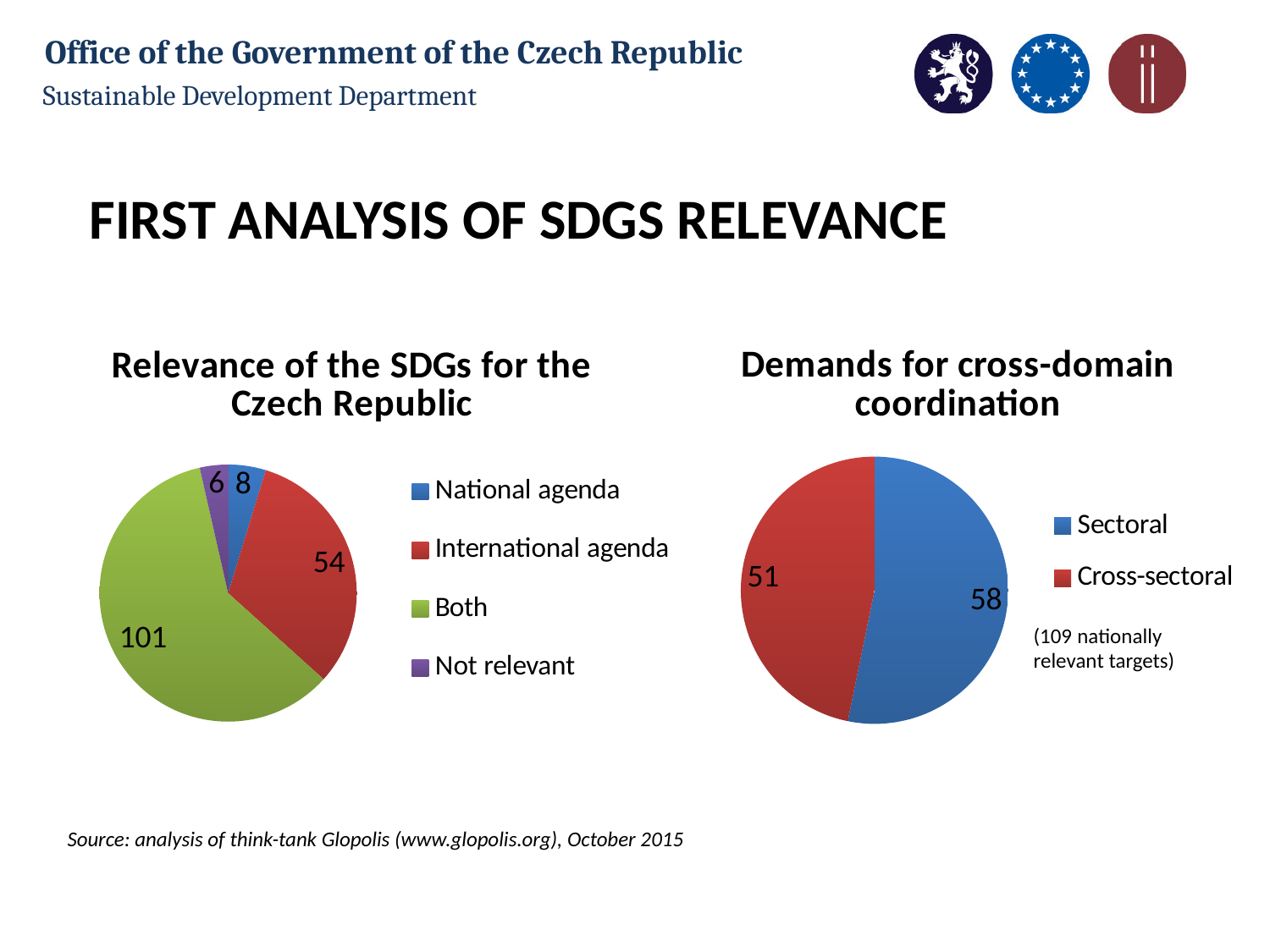
In the 'Relevance of the SDGs for the Czech Republic' chart, what is the value for 'Not relevant'? 6 What type of chart is the 'Demands for cross-domain coordination' chart? Pie chart In the 'Relevance of the SDGs for the Czech Republic' chart, what is the value for 'Both'? 101 In the 'Relevance of the SDGs for the Czech Republic' chart, what is the value for 'International agenda'? 54 In the 'Relevance of the SDGs for the Czech Republic' chart, how many categories are shown? 4 In the 'Demands for cross-domain coordination' chart, what is the value for 'Cross-sectoral'? 51 In the 'Demands for cross-domain coordination' chart, what is the difference between 'Sectoral' and 'Cross-sectoral'? 7 In the 'Demands for cross-domain coordination' chart, what is the value for 'Sectoral'? 58 In the 'Demands for cross-domain coordination' chart, what colour is the 'Cross-sectoral' slice? Red In the 'Relevance of the SDGs for the Czech Republic' chart, what is the difference between 'Both' and 'International agenda'? 47 In the 'Relevance of the SDGs for the Czech Republic' chart, which category has the largest slice? Both In the 'Relevance of the SDGs for the Czech Republic' chart, which category has the smallest slice? Not relevant